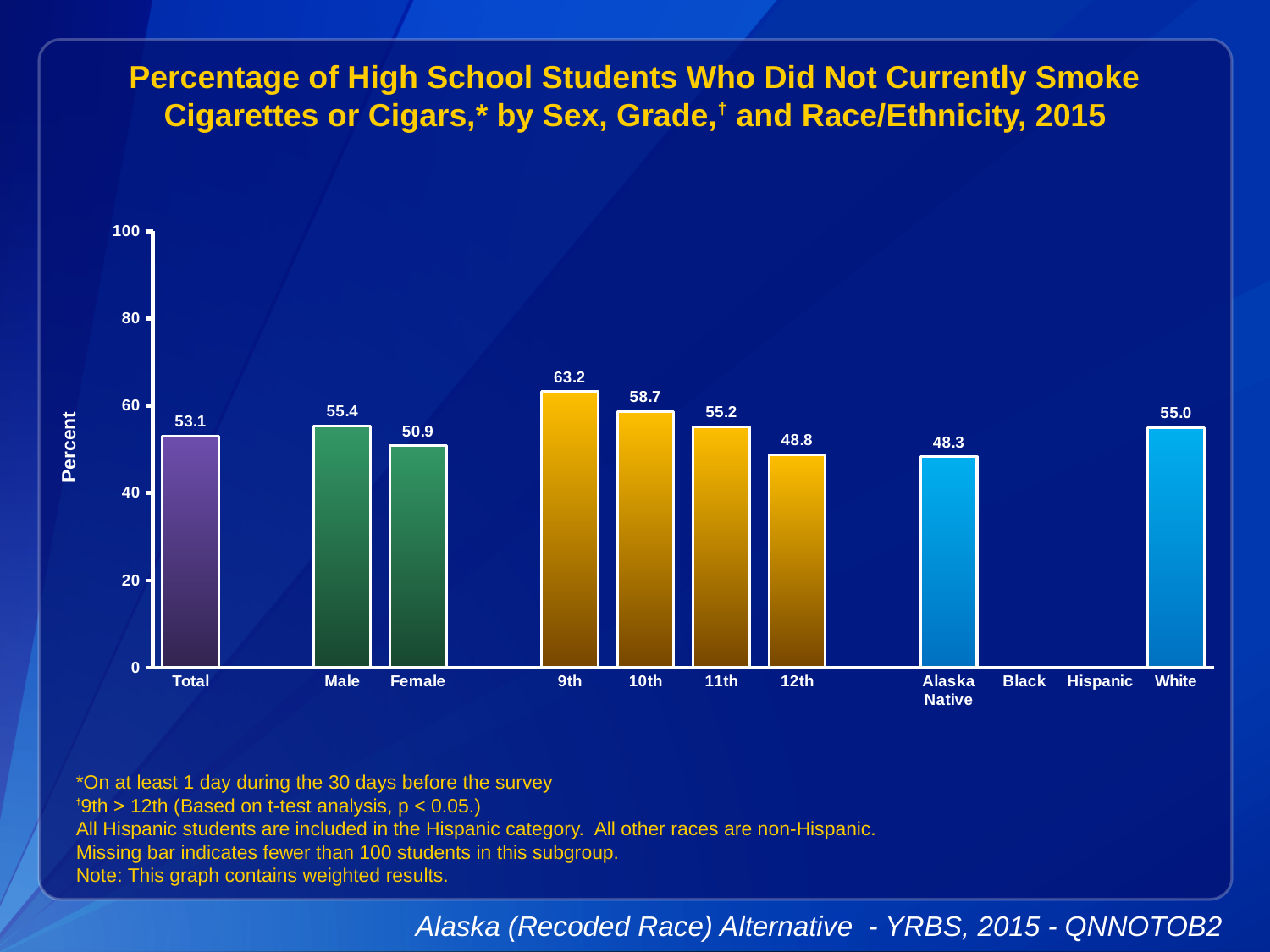
What is the difference between the 9th and 12th grade values? 14.4 Is the value for White greater or less than 60? less What is the value for Female? 50.9 What is the difference between the Male and Female values? 4.5 What is the value for Alaska Native? 48.3 Which category with a bar has the lowest value? Alaska Native What is the value for Total? 53.1 How many categories on the x axis have no bar shown? 2 Which is larger, the value for 10th grade or the value for 11th grade? 10th What kind of chart is shown on the slide? bar chart Which category has the highest value? 9th What is the value for 9th grade? 63.2